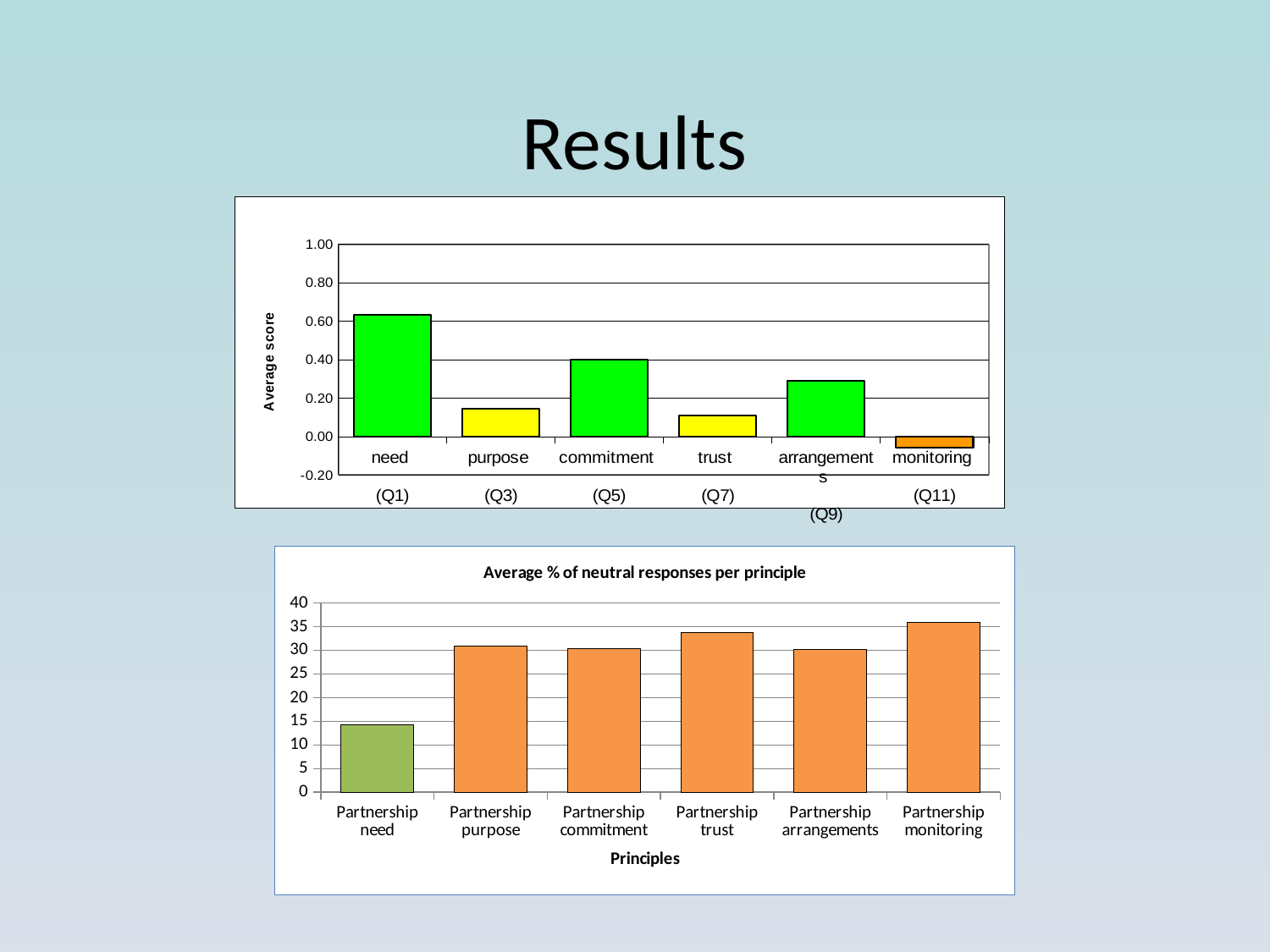
What kind of chart is the bottom chart, titled 'Average % of neutral responses per principle'? bar chart In the bottom chart 'Average % of neutral responses per principle', which principle has the lowest value? Partnership need In the top chart, how many categories are plotted? 6 What kind of chart is the top chart on the slide? bar chart In the top chart, which category has the highest average score? need (Q1) In the top chart, is the value for purpose (Q3) greater or less than 0.20? less In the top chart, which category has the lowest average score? monitoring (Q11) In the bottom chart 'Average % of neutral responses per principle', how many bars are there? 6 In the bottom chart 'Average % of neutral responses per principle', is the value for Partnership need greater or less than 20? less In the bottom chart 'Average % of neutral responses per principle', is the value for Partnership trust greater or less than 30? greater In the top chart, which is larger: the value for need (Q1) or the value for commitment (Q5)? need (Q1)